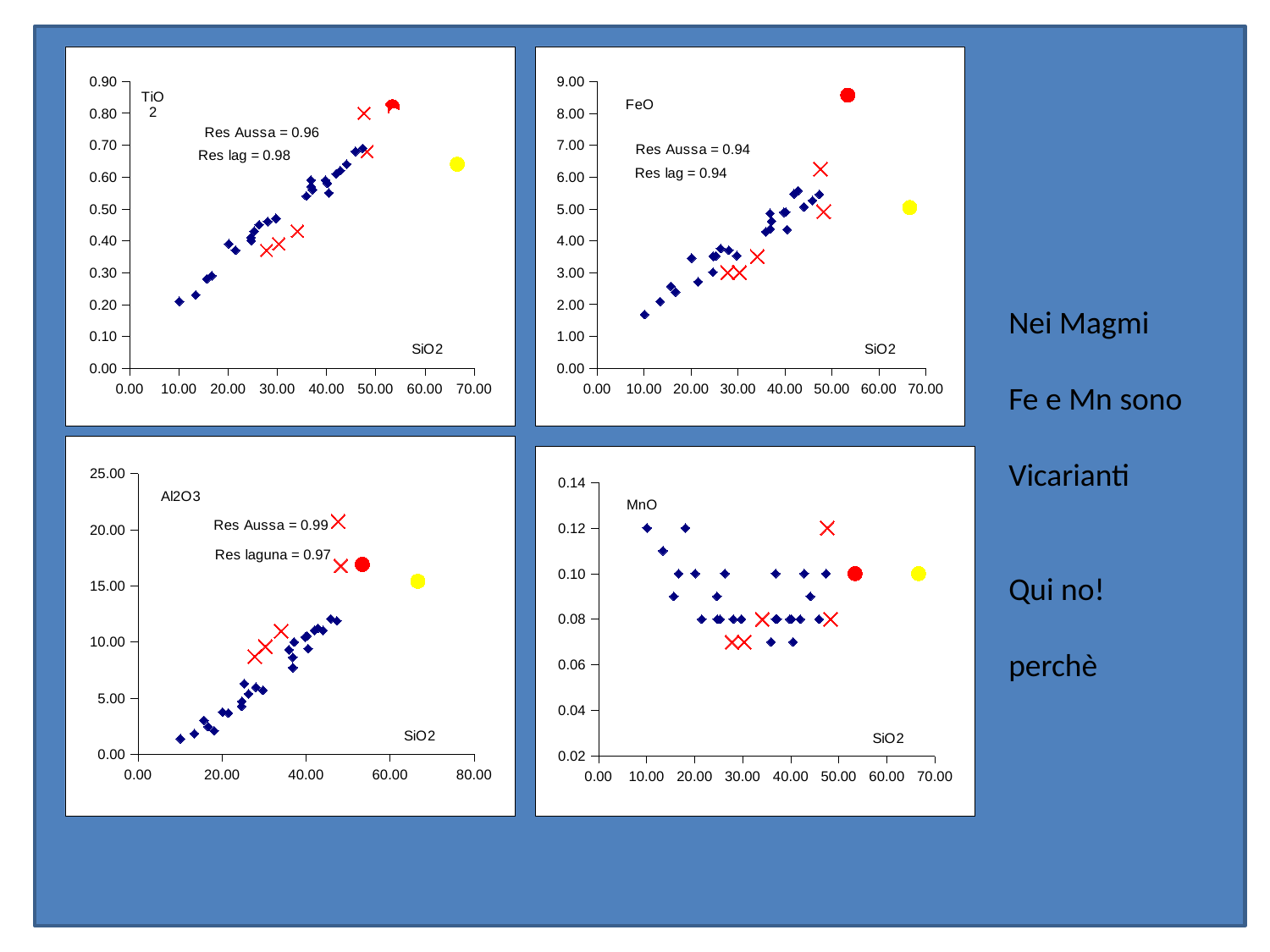
In the Al2O3 chart, do the blue diamond values rise or fall as SiO2 increases? rise In the FeO chart, is the value of the yellow circle greater or less than 6.00? less In the TiO2 chart, is the value of the red circle greater or less than 0.70? greater In the Al2O3 chart, is the value of the yellow circle greater or less than 20.00? less In the TiO2 chart, do the blue diamond values rise or fall as SiO2 increases? rise What kind of chart is the TiO2 chart in the top left? scatter chart What is the Res Aussa value printed on the TiO2 chart? 0.96 What is the Res lag value printed on the FeO chart? 0.94 How many charts are shown on the slide? 4